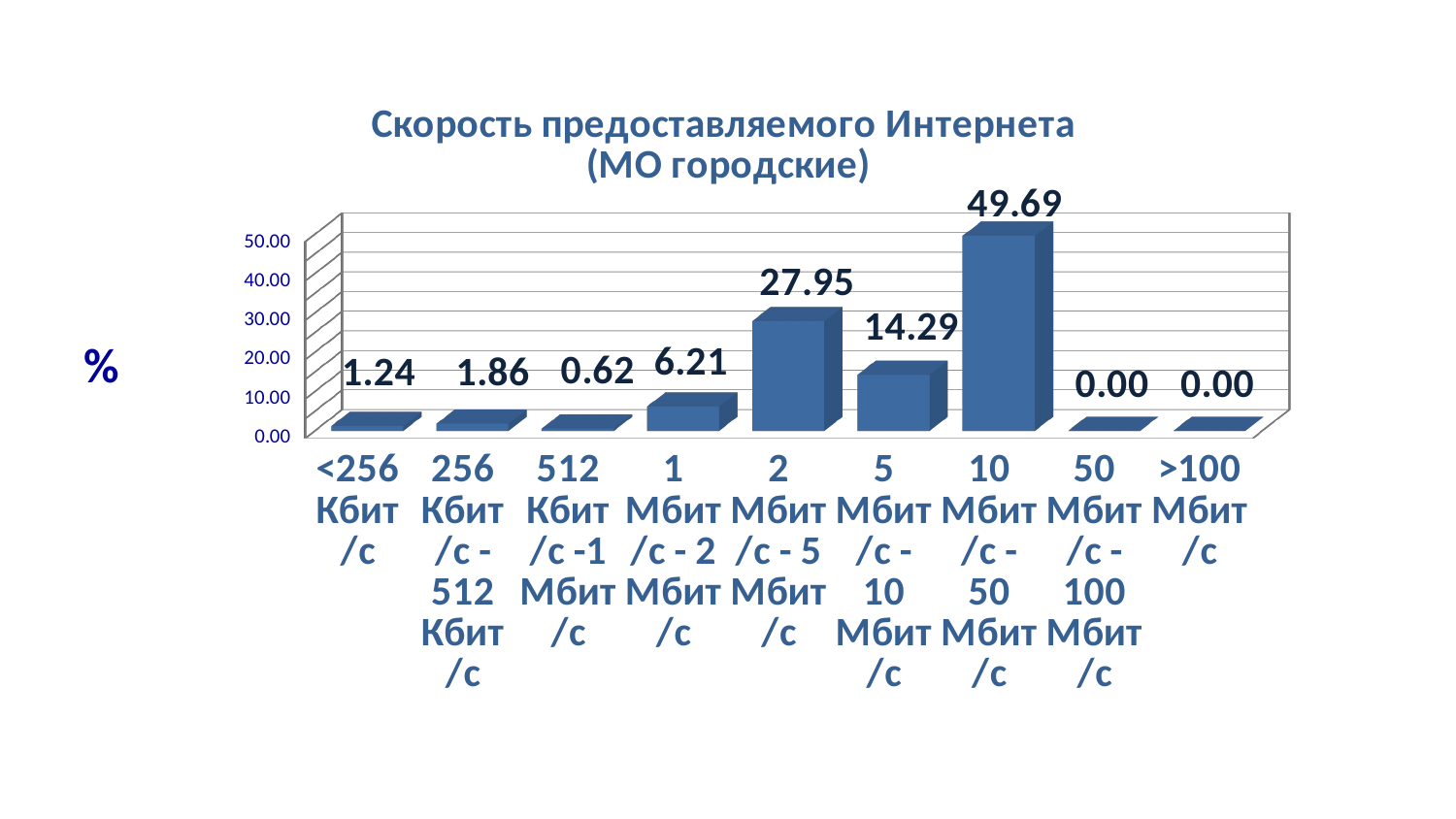
What is the difference between the values for 5 Мбит/с - 10 Мбит/с and 1 Мбит/с - 2 Мбит/с? 8.08 What is the difference between the values for 10 Мбит/с - 50 Мбит/с and 2 Мбит/с - 5 Мбит/с? 21.74 Is the value for 5 Мбит/с - 10 Мбит/с greater or less than 20.00? less Which is larger, the value for 256 Кбит/с - 512 Кбит/с or the value for 512 Кбит/с - 1 Мбит/с? 256 Кбит/с - 512 Кбит/с What is the value for the 2 Мбит/с - 5 Мбит/с category? 27.95 Which category has the highest value? 10 Мбит/с - 50 Мбит/с What type of chart is shown on the slide? bar chart What is the value for the 10 Мбит/с - 50 Мбит/с category? 49.69 How many categories are shown on the x axis? 9 What is the value for the <256 Кбит/с category? 1.24 What is the value for the 512 Кбит/с - 1 Мбит/с category? 0.62 How many categories have a value of 0.00? 2